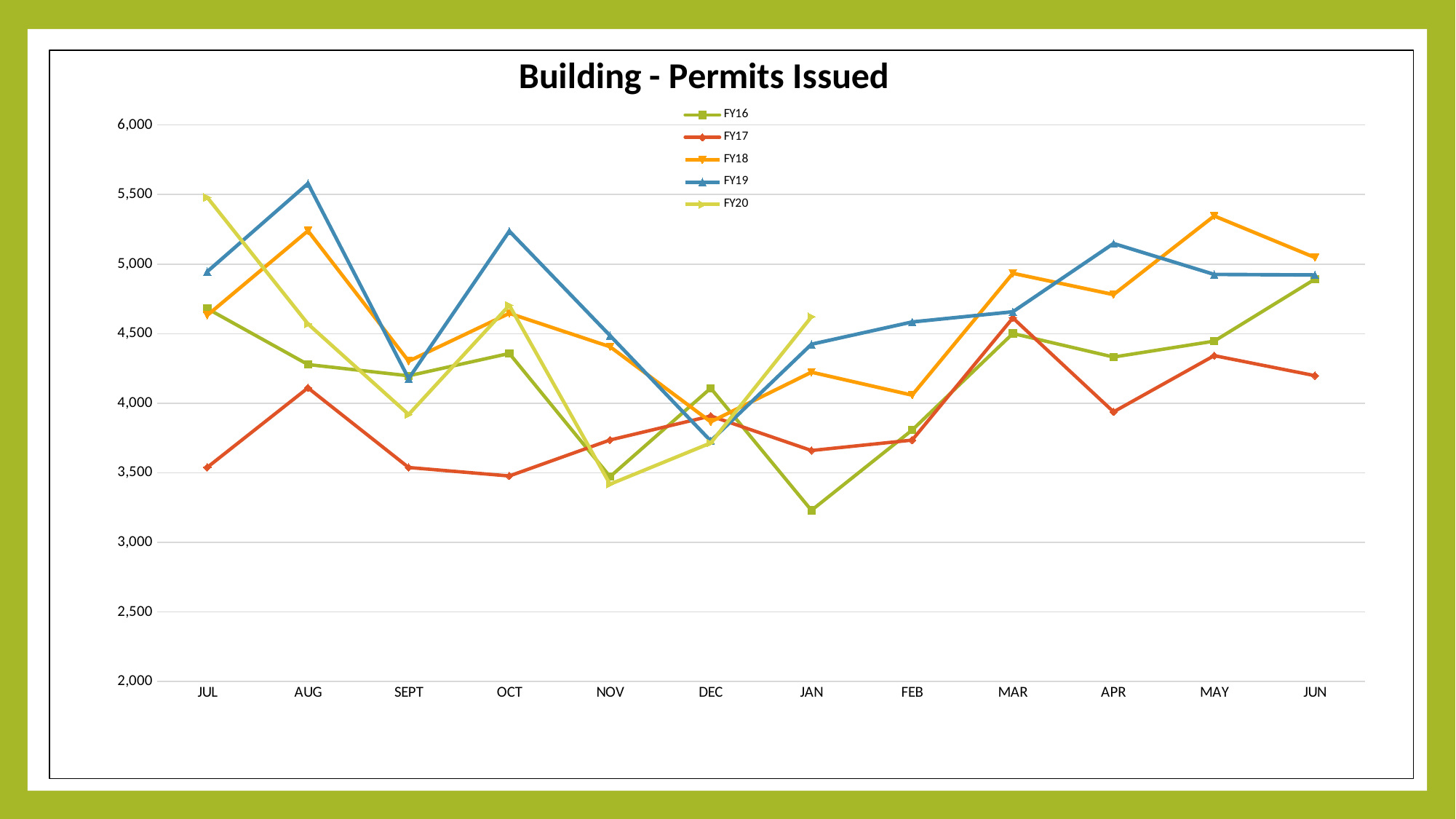
In which month does the FY16 series reach its lowest value? JAN Does the FY19 series rise or fall from JAN to APR? rise How many series does the legend list? 5 In which month does the FY19 series reach its highest value? AUG Is the FY19 value for AUG greater or less than 5,500? greater What is the title of the chart? Building - Permits Issued In JAN, which series has the larger value, FY16 or FY20? FY20 Is the FY16 value for JAN greater or less than 3,500? less Is the FY18 value for MAY greater or less than 5,000? greater How many months are shown along the x axis? 12 What kind of chart is shown on the slide? line chart In which month does the FY20 series reach its lowest value? NOV